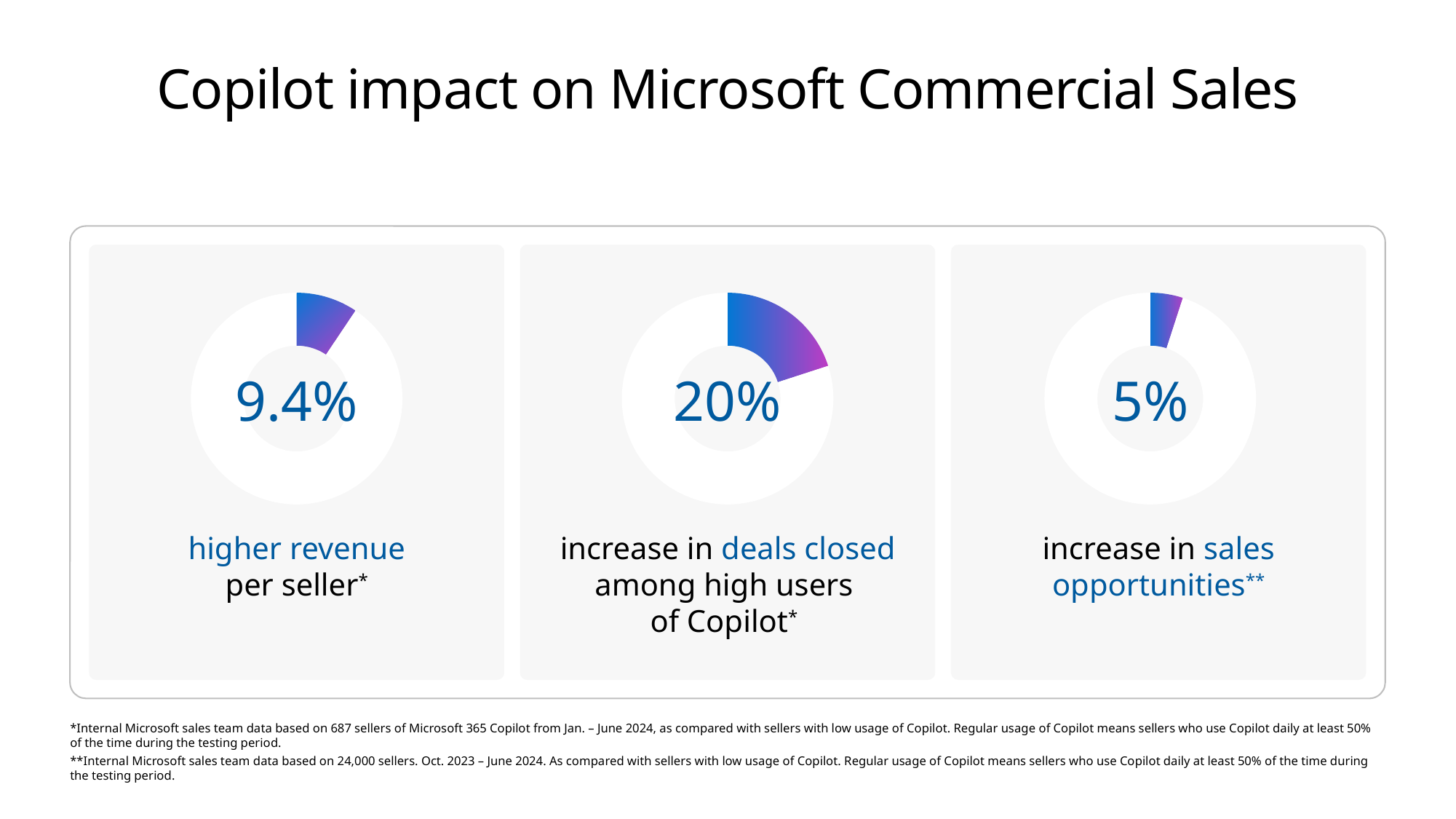
What is the title of the slide? Copilot impact on Microsoft Commercial Sales Which of the three metrics on the slide has the lowest value? increase in sales opportunities Which of the three metrics on the slide has the highest value? increase in deals closed among high users of Copilot What kind of chart is used to display each metric on the slide? donut chart Which is larger: the higher revenue per seller value or the increase in sales opportunities value? higher revenue per seller What is the difference between the increase in deals closed (middle chart) and the higher revenue per seller (left chart)? 10.6% What value is shown in the right chart for the increase in sales opportunities? 5% What value is shown in the middle chart for the increase in deals closed among high users of Copilot? 20% What is the difference between the higher revenue per seller (left chart) and the increase in sales opportunities (right chart)? 4.4% How many charts are shown on the slide? 3 What is the difference between the increase in deals closed (middle chart) and the increase in sales opportunities (right chart)? 15% What value is shown in the left chart for higher revenue per seller? 9.4%